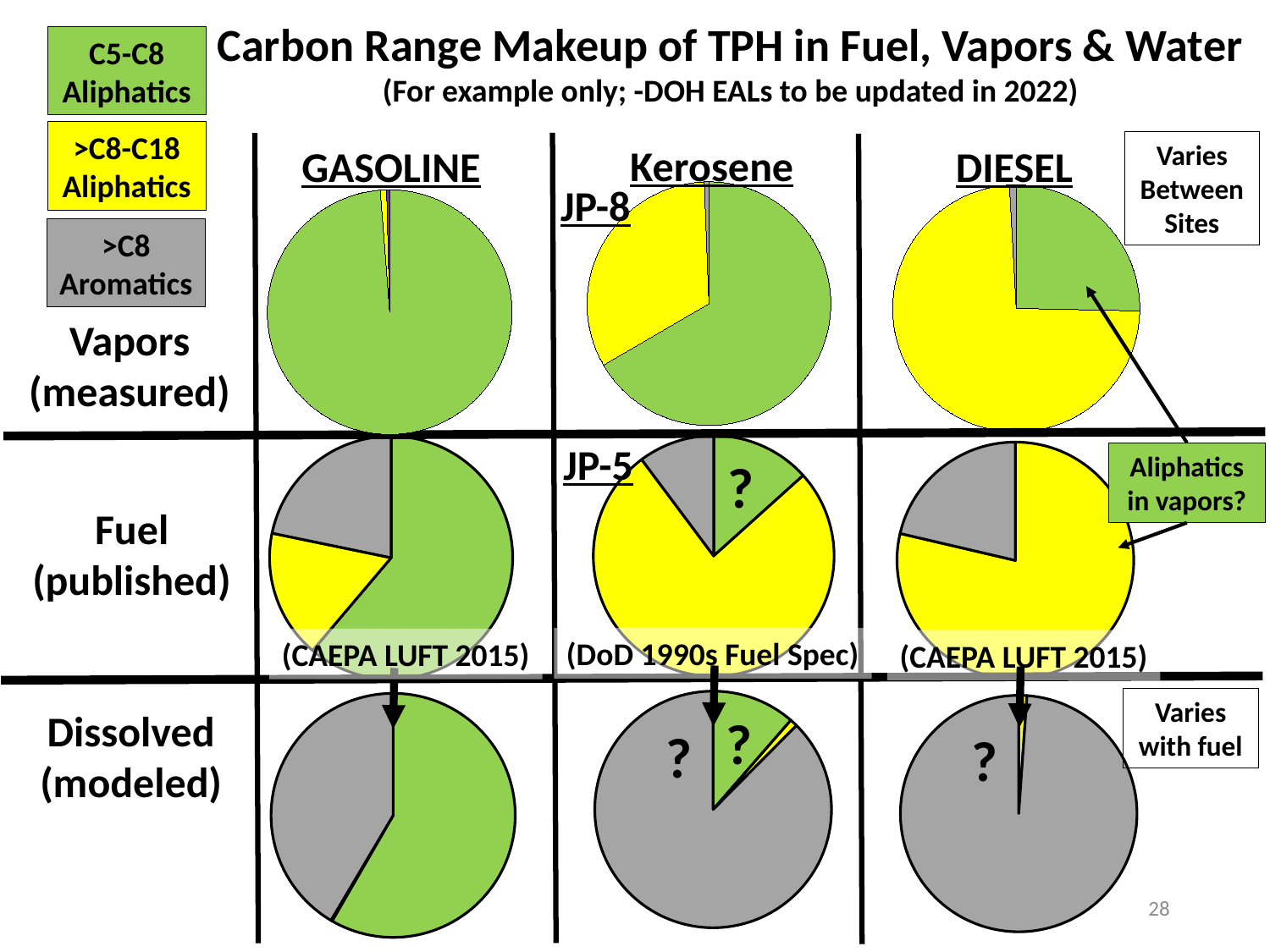
In the Kerosene JP-5 Fuel (published) pie chart, which category has the largest slice? >C8-C18 Aliphatics In the Kerosene JP-8 Vapors (measured) pie chart, which category has the largest slice? C5-C8 Aliphatics What colour does the legend use for >C8 Aromatics? Gray In the Gasoline Fuel (published) pie chart, which category has the largest slice? C5-C8 Aliphatics In the Gasoline Dissolved (modeled) pie chart, which slice is larger: C5-C8 Aliphatics or >C8 Aromatics? C5-C8 Aliphatics How many carbon range categories does the legend list? 3 What kind of charts are shown on the slide? Pie charts How many pie charts are on the slide? 9